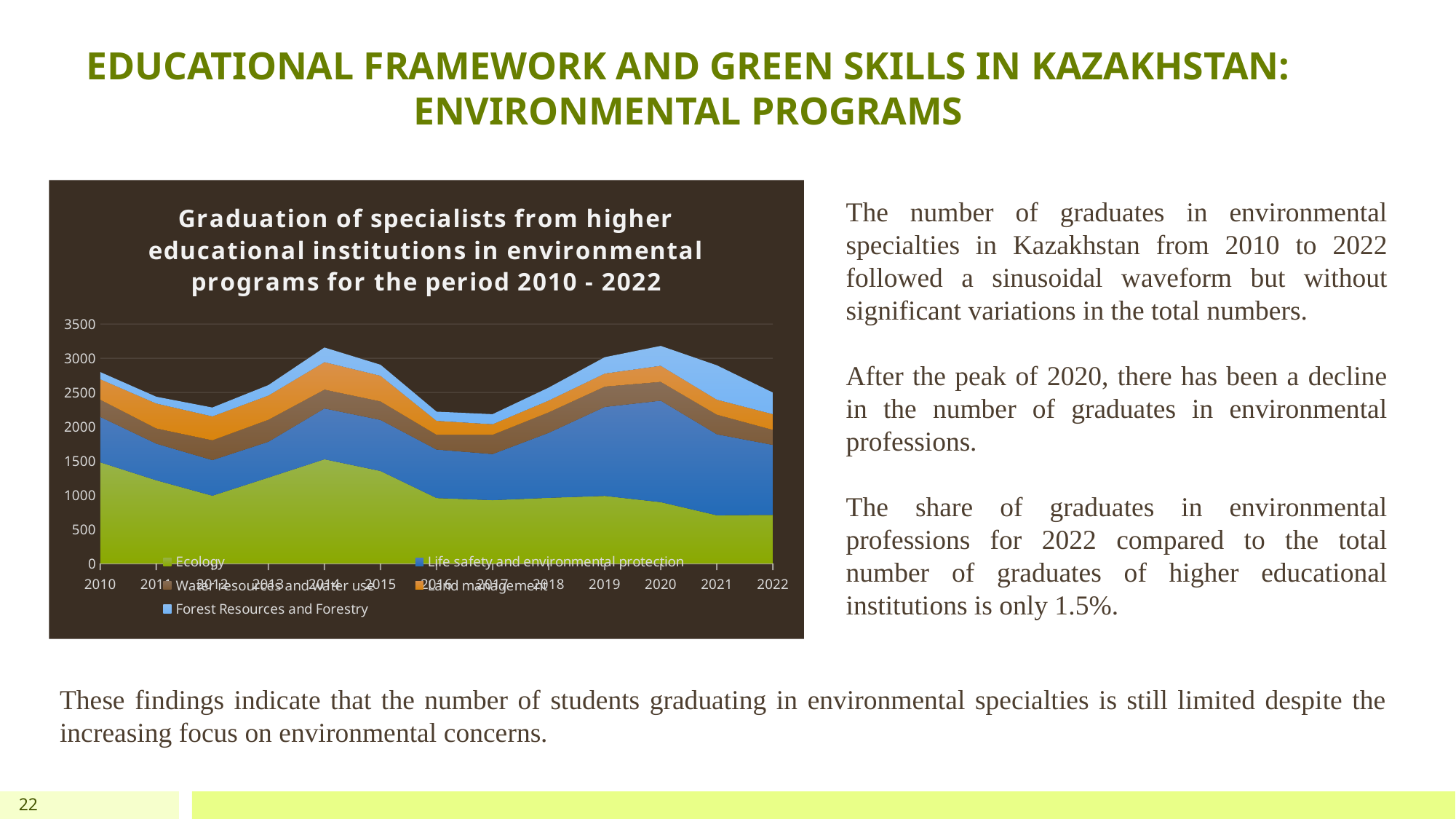
Is the total stacked value for 2017 greater or less than 2500? less What kind of chart is shown on the slide? Stacked area chart Is the total stacked value for 2012 greater or less than 2500? less Does the total number of graduates rise or fall from 2012 to 2014? rise Which series is plotted as the bottom (green) layer of the stacked area chart? Ecology Is the value for Ecology in 2022 greater or less than 1000? less Does the total number of graduates rise or fall from 2020 to 2022? fall How many years are plotted along the x axis of the chart? 13 What is the title of the chart? Graduation of specialists from higher educational institutions in environmental programs for the period 2010 - 2022 How many series does the chart legend list? 5